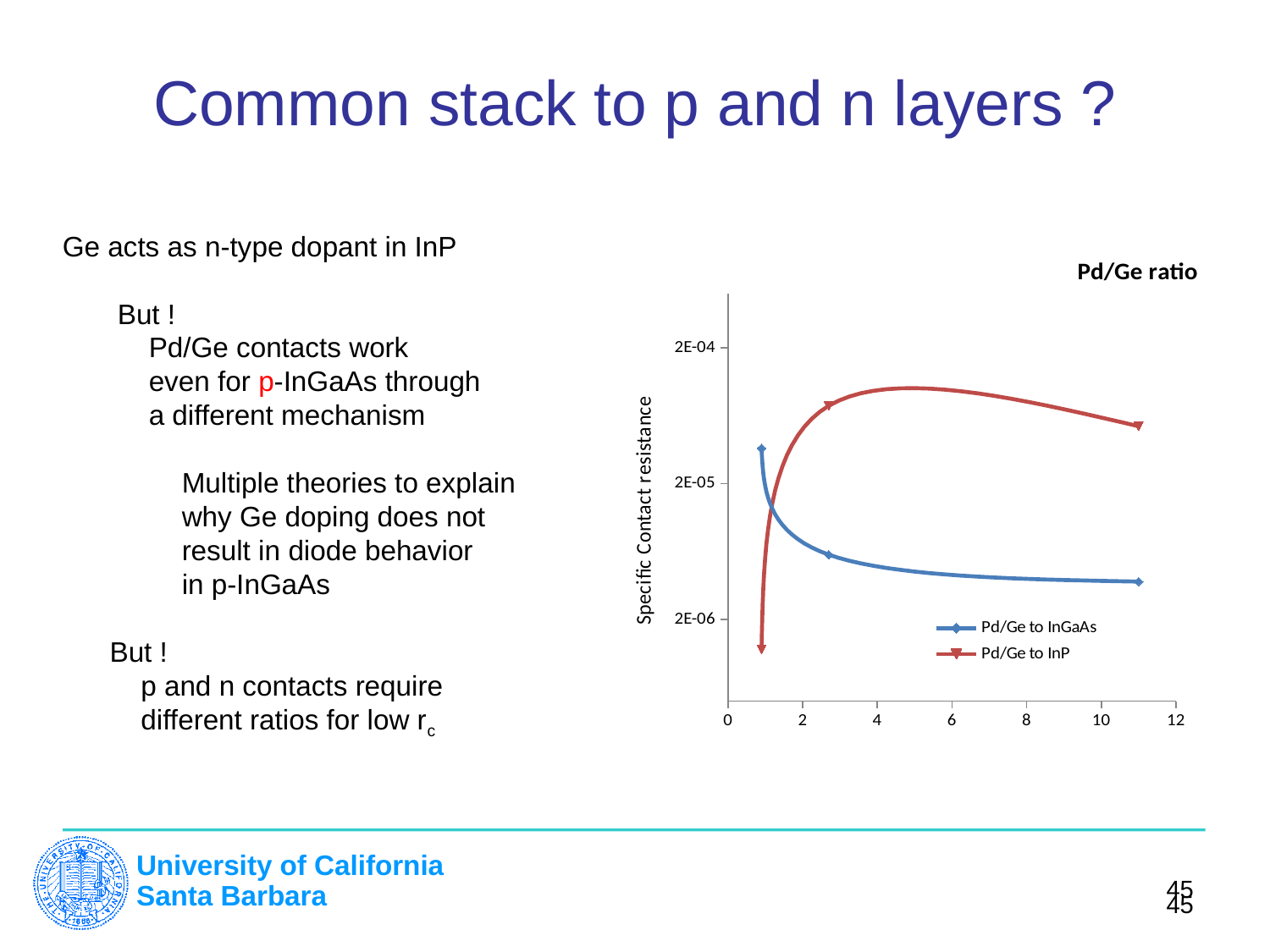
What is the label on the vertical axis of the chart? Specific Contact resistance Is the value of the Pd/Ge to InGaAs series at its rightmost point (ratio about 11) greater or less than 2E-06? greater At a Pd/Ge ratio of about 1, which series has the higher specific contact resistance? Pd/Ge to InGaAs Which series reaches the highest specific contact resistance anywhere on the chart? Pd/Ge to InP What are the two series named in the chart legend? Pd/Ge to InGaAs and Pd/Ge to InP Is the value of the Pd/Ge to InP series at its leftmost point (ratio about 1) greater or less than 2E-06? less What kind of chart is shown on the slide? line chart At a Pd/Ge ratio of about 11, which series has the higher specific contact resistance? Pd/Ge to InP Does the Pd/Ge to InGaAs series rise or fall as the Pd/Ge ratio increases? falls How many data points are plotted for the Pd/Ge to InGaAs series? 3 How many series does the chart legend list? 2 Is the value of the Pd/Ge to InP series at its rightmost point (ratio about 11) greater or less than 2E-05? greater